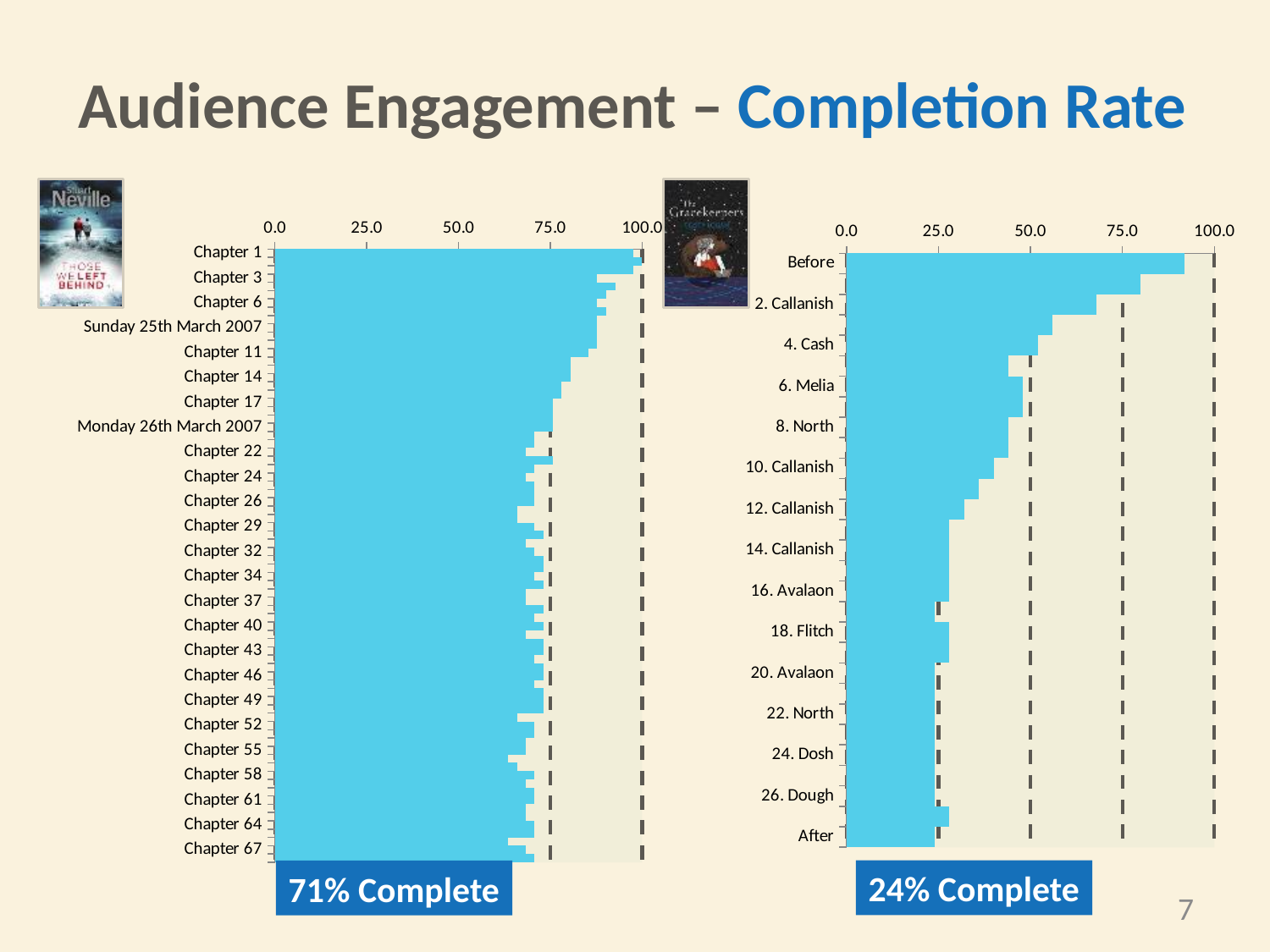
In the left chart, is the value for Chapter 67 greater or less than 75.0? less What kind of chart is the right chart (Before to After)? bar chart In the left chart, is the value for Chapter 1 greater or less than 75.0? greater What kind of chart is the left chart (Chapter 1 to Chapter 67)? bar chart In the right chart, is the value for After greater or less than 50.0? less What completion rate is shown in the box below the right chart? 24% Complete In the left chart, do the values generally rise or fall going from Chapter 1 down to Chapter 67? fall In the right chart, which is larger, the value for Before or the value for After? Before In the right chart, which category has the highest value? Before What completion rate is shown in the box below the left chart? 71% Complete